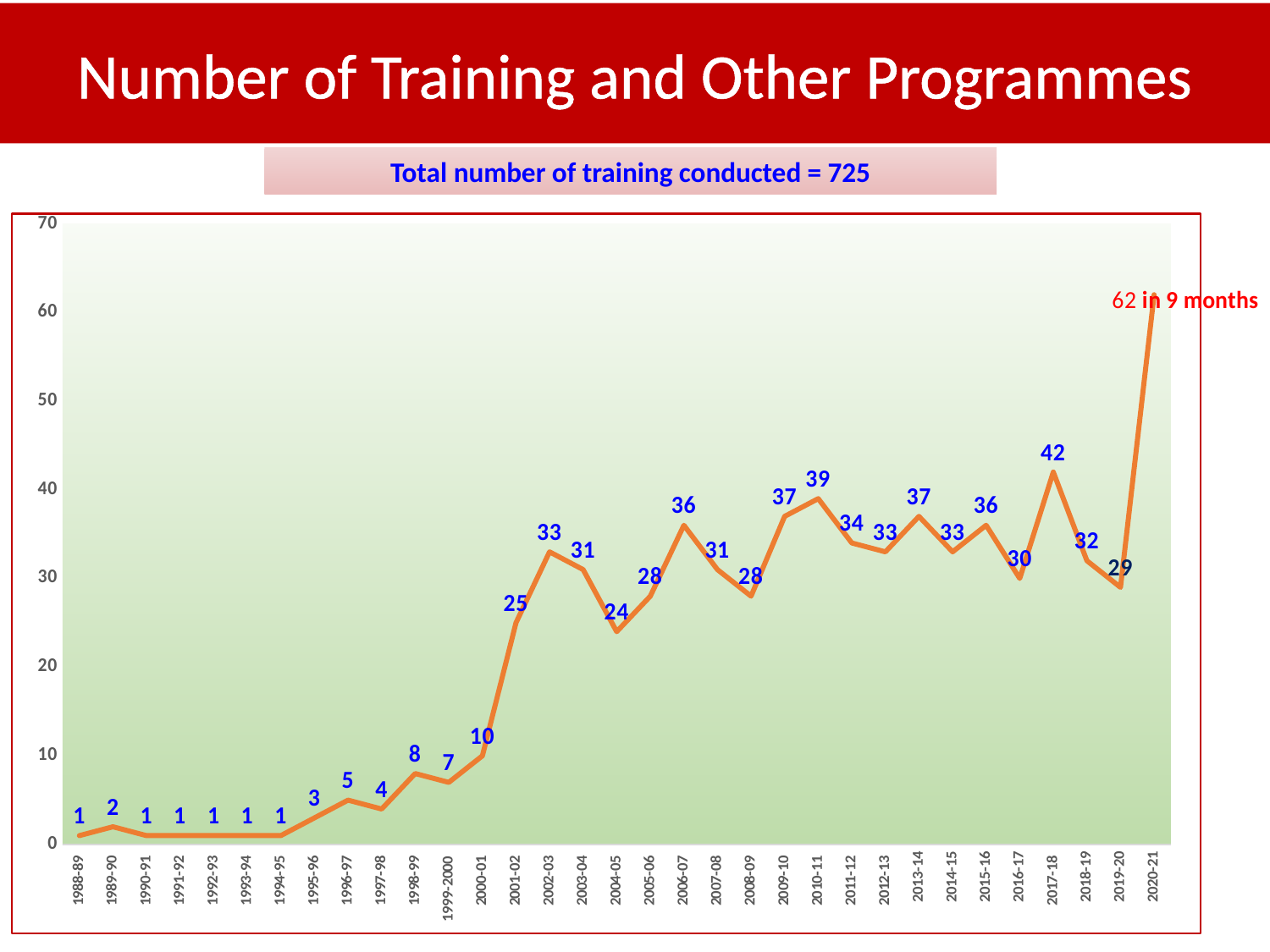
How many years are plotted on the x axis? 33 What kind of chart is shown on the slide? line chart Do the values generally rise or fall from 1988-89 to 2020-21? rise What is the difference between the values for 2020-21 and 2019-20? 33 What is the value for 2020-21? 62 Which year has the highest value? 2020-21 What total number of training conducted is stated on the slide? 725 Which is larger, the value for 2006-07 or the value for 2005-06? 2006-07 What is the value for 2010-11? 39 What is the value for 2017-18? 42 What is the value for 2001-02? 25 What is the difference between the values for 2017-18 and 2016-17? 12